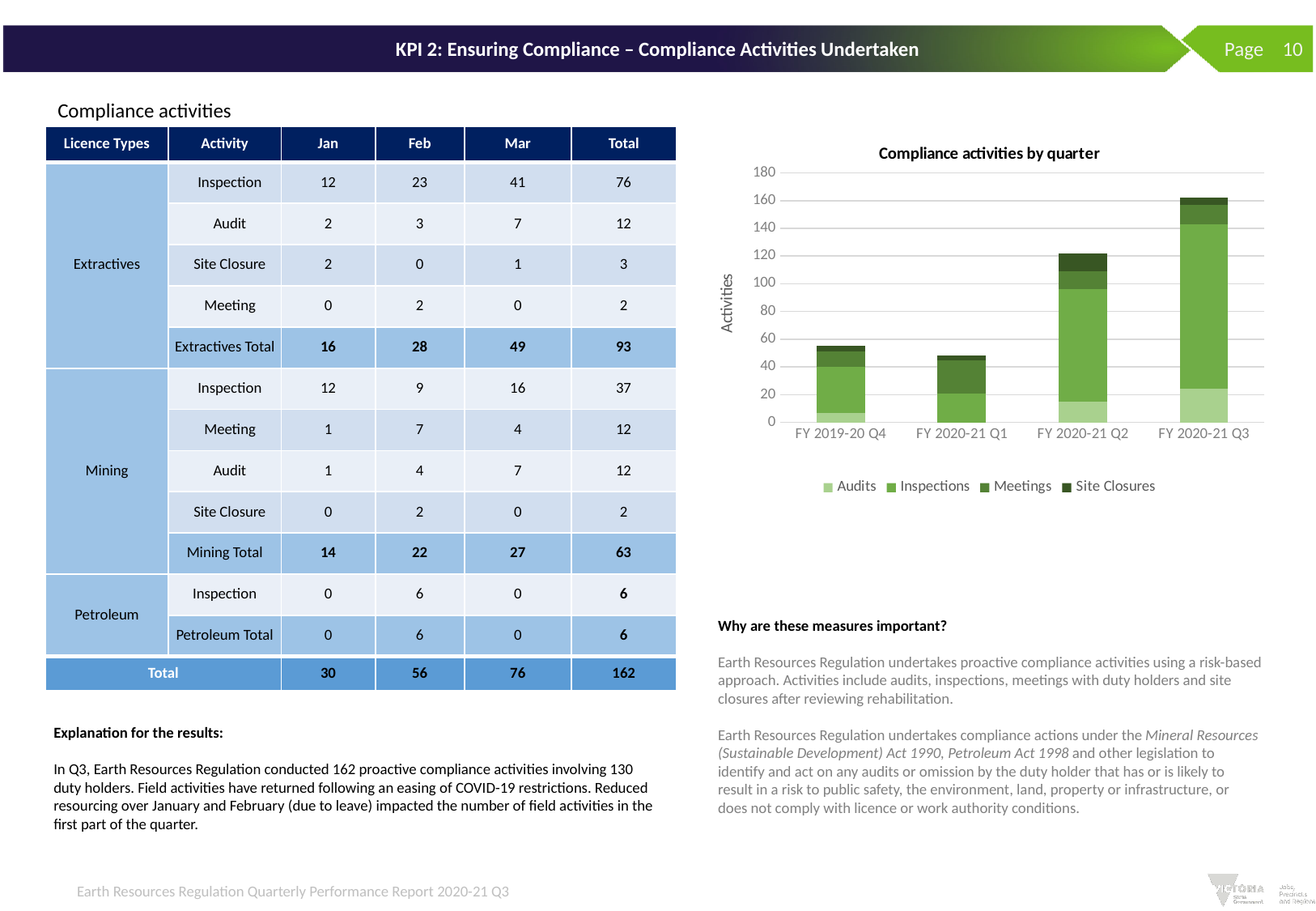
What is the y-axis label of the 'Compliance activities by quarter' chart? Activities Which series is listed first in the legend of the 'Compliance activities by quarter' chart? Audits How many series does the legend of the 'Compliance activities by quarter' chart list? 4 In the 'Compliance activities by quarter' chart, is the total bar for FY 2019-20 Q4 greater or less than 80? less In the 'Compliance activities by quarter' chart, do the total bars rise or fall from FY 2020-21 Q1 to FY 2020-21 Q3? rise How many quarters are shown on the x axis of the 'Compliance activities by quarter' chart? 4 In the 'Compliance activities by quarter' chart, is the total bar for FY 2020-21 Q3 greater or less than 140? greater Which quarter has the tallest stacked bar in the 'Compliance activities by quarter' chart? FY 2020-21 Q3 In the 'Compliance activities by quarter' chart, is the total bar for FY 2020-21 Q2 greater or less than 100? greater Which quarter has the shortest stacked bar in the 'Compliance activities by quarter' chart? FY 2020-21 Q1 In the 'Compliance activities by quarter' chart, which bar is taller: FY 2020-21 Q2 or FY 2020-21 Q1? FY 2020-21 Q2 What type of chart is 'Compliance activities by quarter'? stacked bar chart